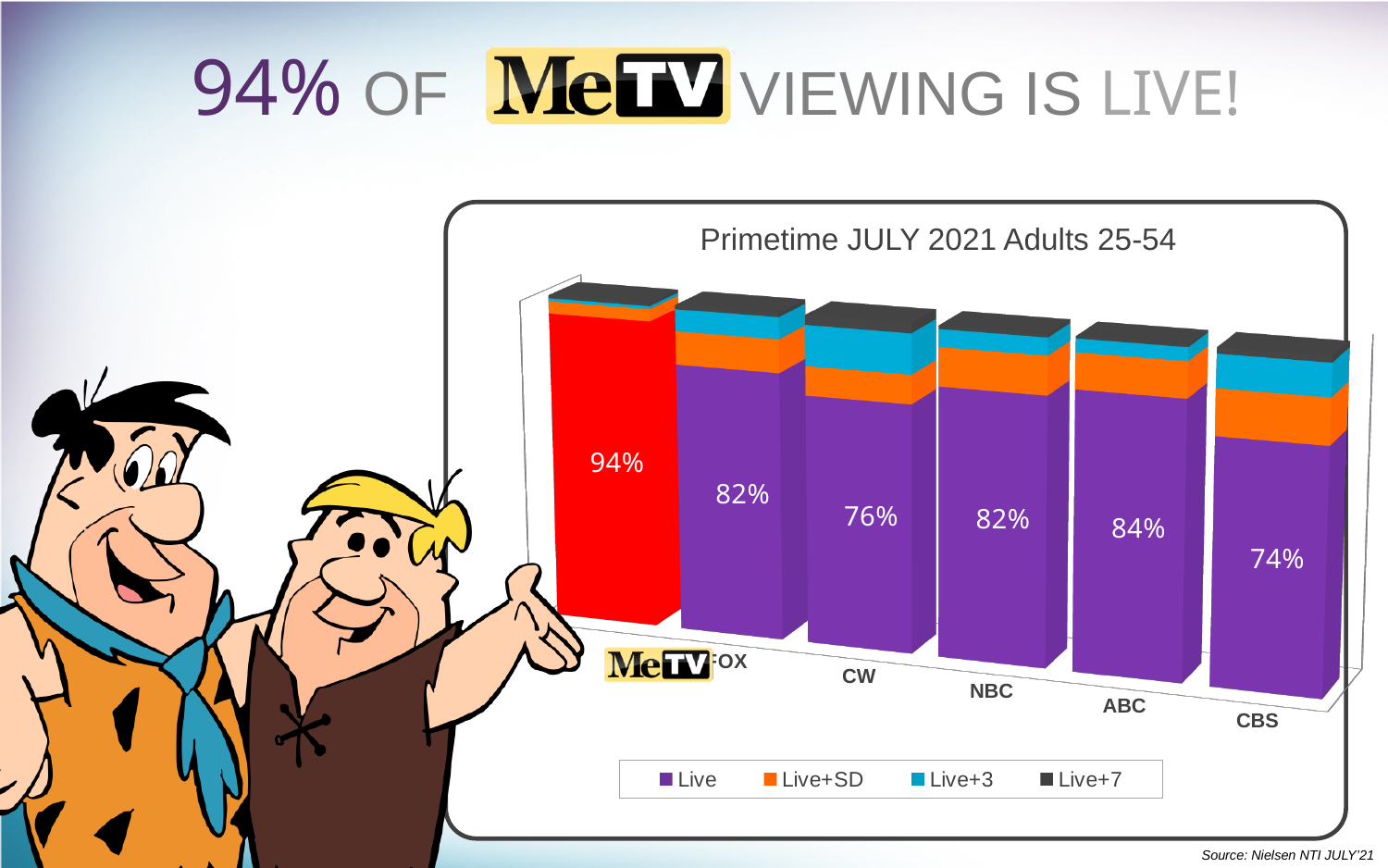
How many series does the chart legend list? 4 Which network has the lowest Live share in the chart? CBS Which has a larger Live share, ABC or CW? ABC What is the Live share for CBS in the chart? 74% What kind of chart is shown on the slide? Stacked bar chart What is the Live share for ABC in the chart? 84% What is the difference in Live share between MeTV and CBS? 20 percentage points What is the Live share for CW in the chart? 76% Which network has the highest Live share in the chart? MeTV What is the Live share for MeTV in the chart? 94% What is the title of the chart? Primetime JULY 2021 Adults 25-54 How many networks are shown in the chart? 6